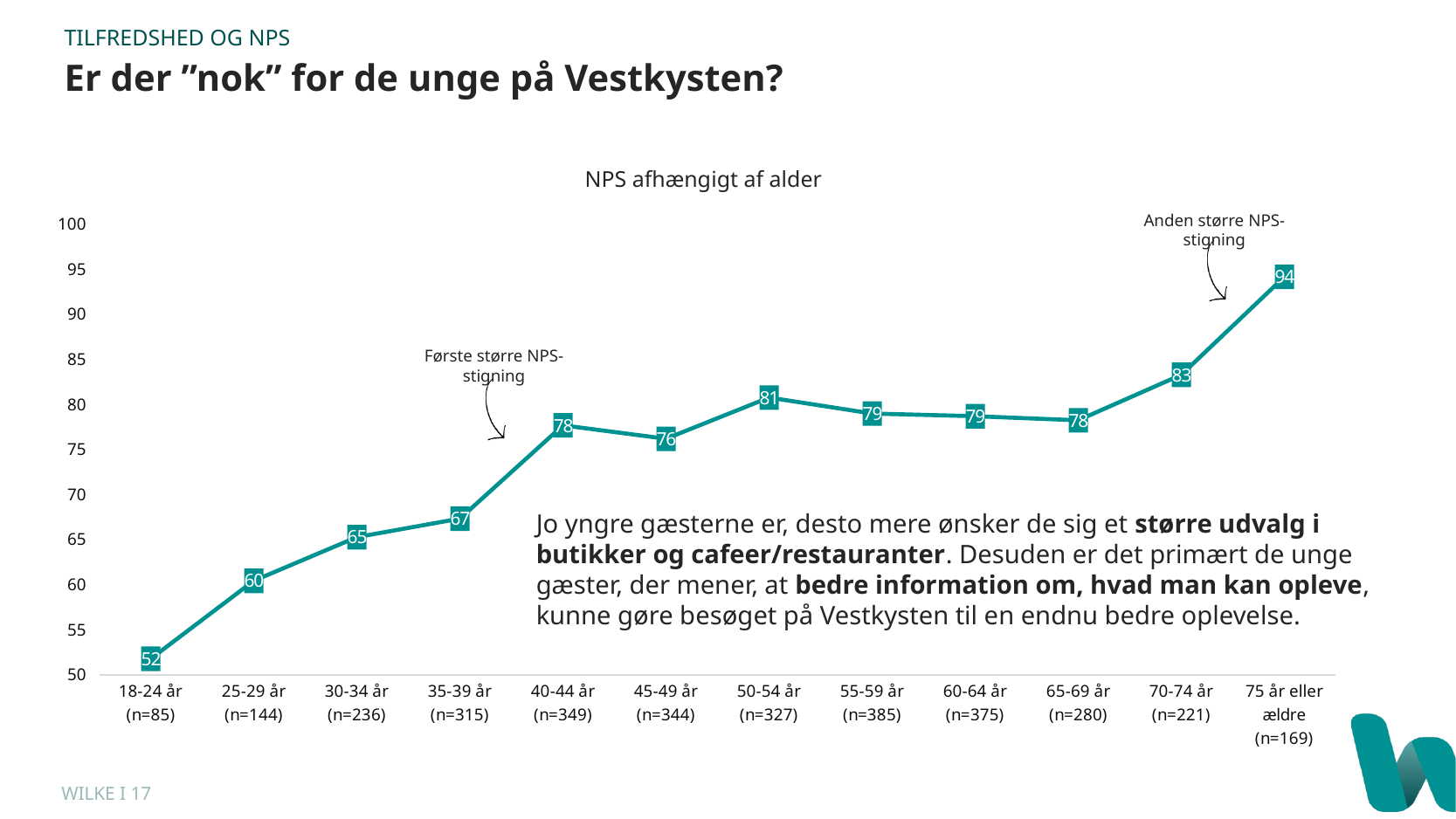
What is the NPS value for the 18-24 år age group? 52 What kind of chart is shown on the slide? line chart What is the NPS value for the 75 år eller ældre age group? 94 Is the NPS value for the 30-34 år group greater or less than 70? less Which has a higher NPS, the 45-49 år group or the 50-54 år group? 50-54 år Which age group has the lowest NPS? 18-24 år What is the difference in NPS between the 40-44 år group and the 35-39 år group? 11 What is the NPS value for the 50-54 år age group? 81 What is the title of the chart? NPS afhængigt af alder Does the NPS generally rise or fall as age increases along the x axis? rise Which age group has the highest NPS? 75 år eller ældre How many age groups are plotted on the chart? 12